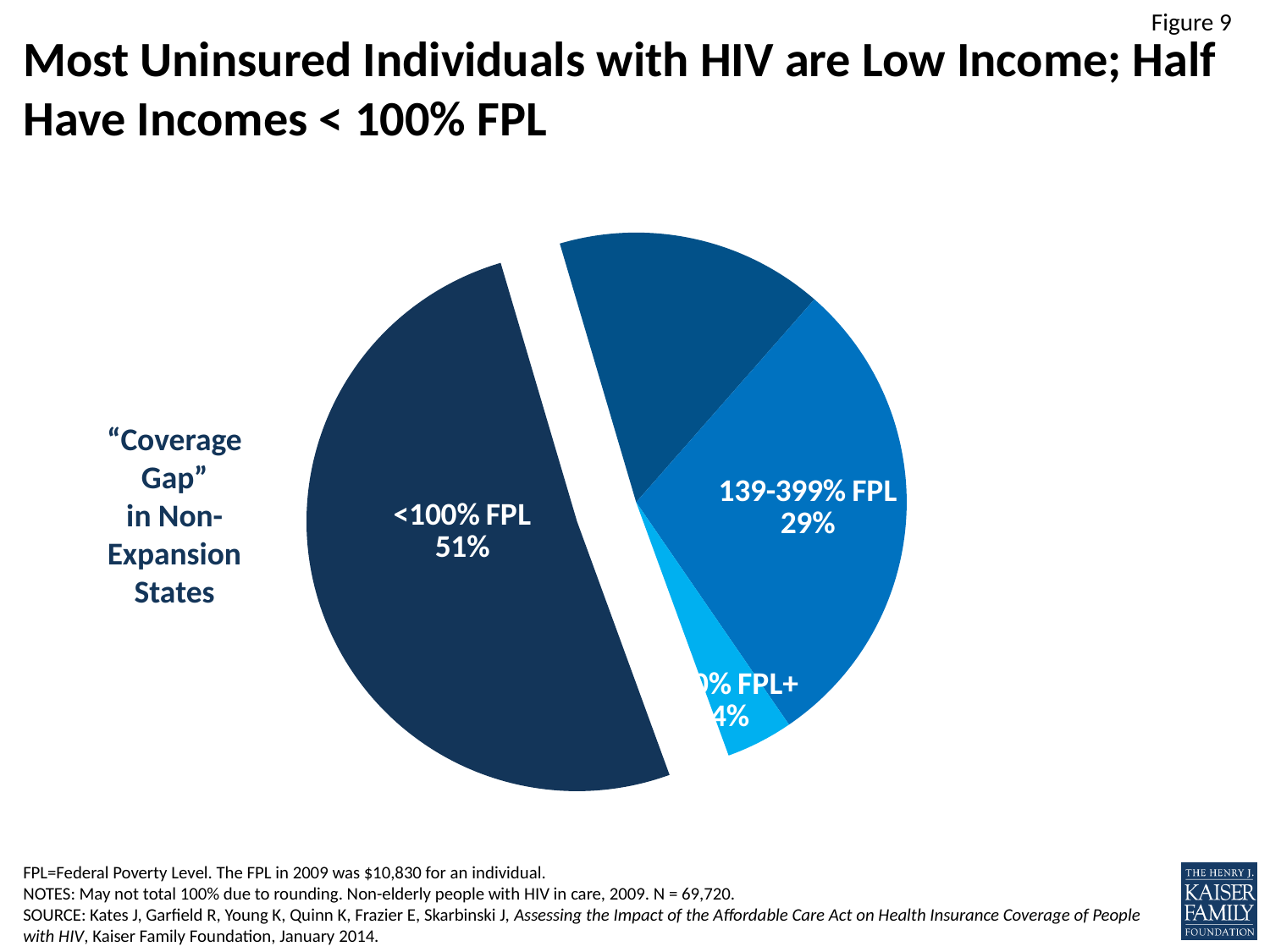
Which slice is annotated as the "Coverage Gap" in Non-Expansion States? <100% FPL What share of uninsured individuals with HIV have incomes <100% FPL? 51% What is the smallest percentage printed on the pie chart? 4% What kind of chart is shown on the slide? pie chart Which income category has the largest slice of the pie? <100% FPL What percentage is shown for the 139-399% FPL slice? 29% What is the difference in percentage points between the <100% FPL slice and the 139-399% FPL slice? 22 percentage points Which is larger, the <100% FPL slice or the 139-399% FPL slice? <100% FPL Is the share for 139-399% FPL greater or less than 30%? less What is the title of the slide? Most Uninsured Individuals with HIV are Low Income; Half Have Incomes < 100% FPL How many slices does the pie chart have? 4